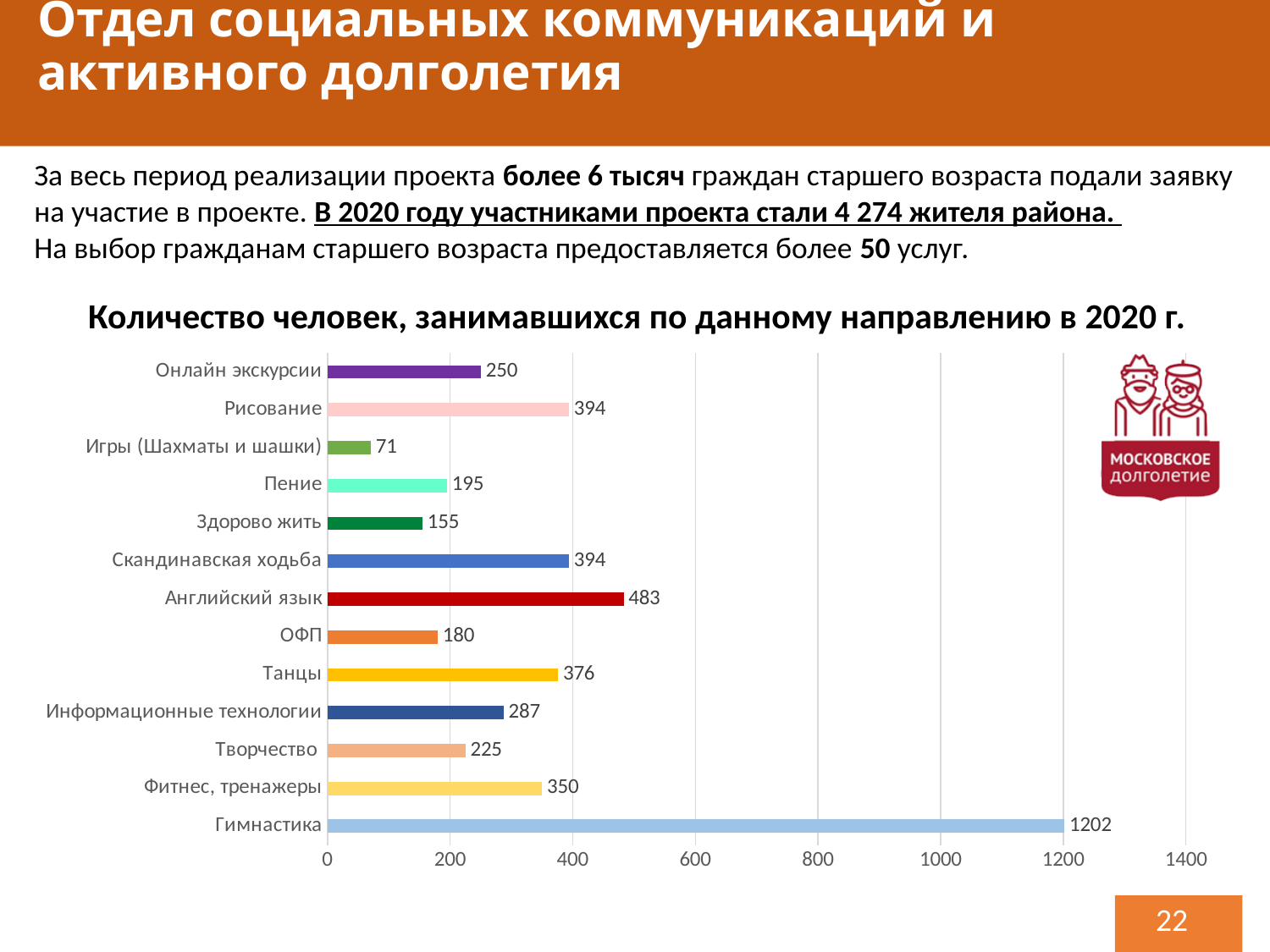
How many categories are shown in the chart? 13 What is the title of the chart? Количество человек, занимавшихся по данному направлению в 2020 г. What is the value for ОФП? 180 Which category has the highest value? Гимнастика Is the value for Информационные технологии greater or less than 200? greater What is the difference between the values for Гимнастика and Английский язык? 719 Which category has the lowest value? Игры (Шахматы и шашки) What kind of chart is shown on the slide? bar chart What is the value for Игры (Шахматы и шашки)? 71 What is the value for Английский язык? 483 Which is larger, the value for Танцы or the value for Фитнес, тренажеры? Танцы What is the value for Гимнастика? 1202